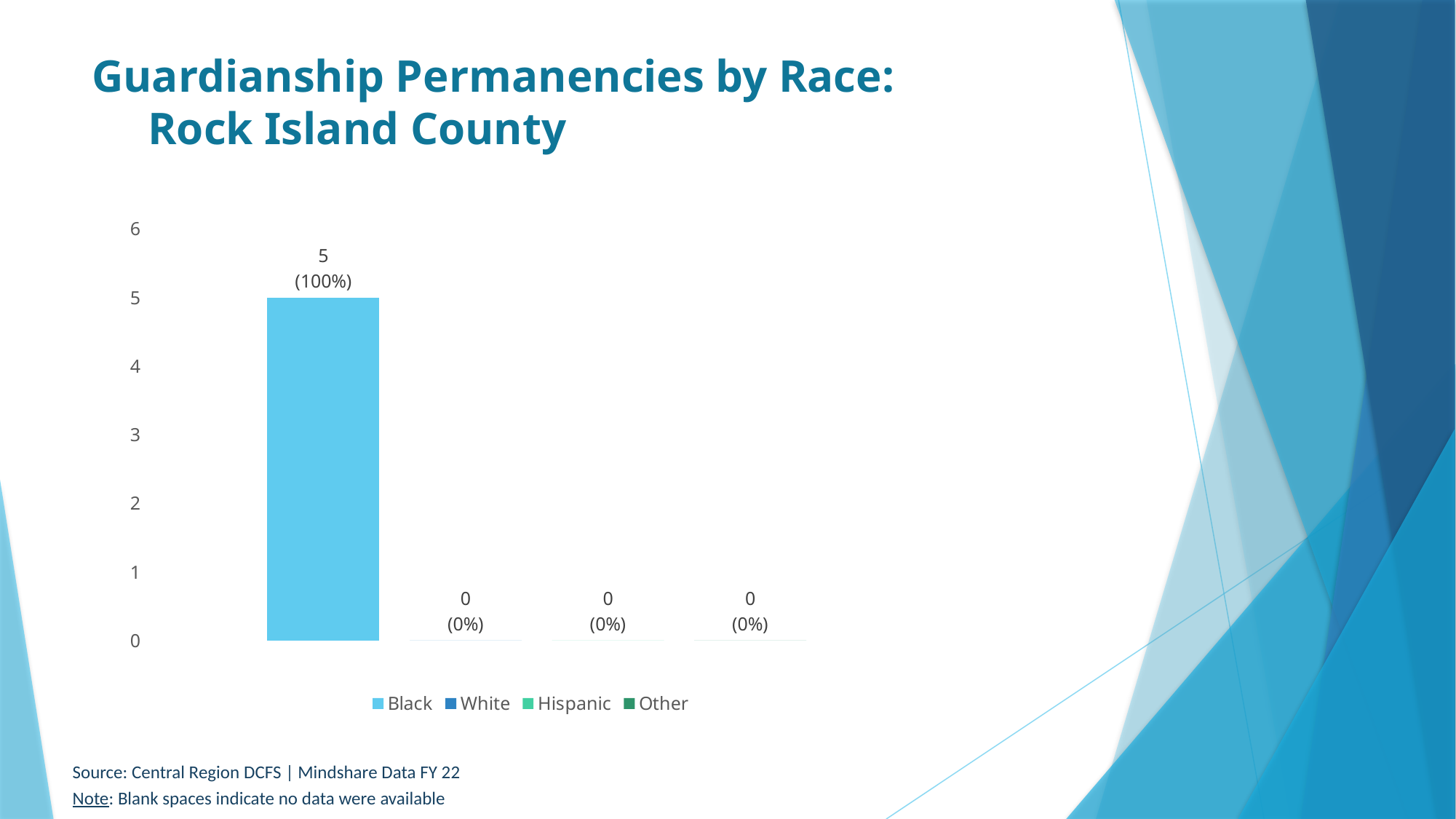
Is the value for Black greater or less than 4? greater What percentage is shown for Other? 0% What is the difference between the values for Black and White? 5 What is the value for Black in the Guardianship Permanencies by Race: Rock Island County chart? 5 What is the title of the chart on the slide? Guardianship Permanencies by Race: Rock Island County What percentage is shown for Black? 100% How many series does the legend list? 4 Which is larger, the value for Black or the value for Hispanic? Black Which race category has the highest value? Black What is the value for Hispanic? 0 What kind of chart is shown on the slide? Bar chart What is the value for White? 0